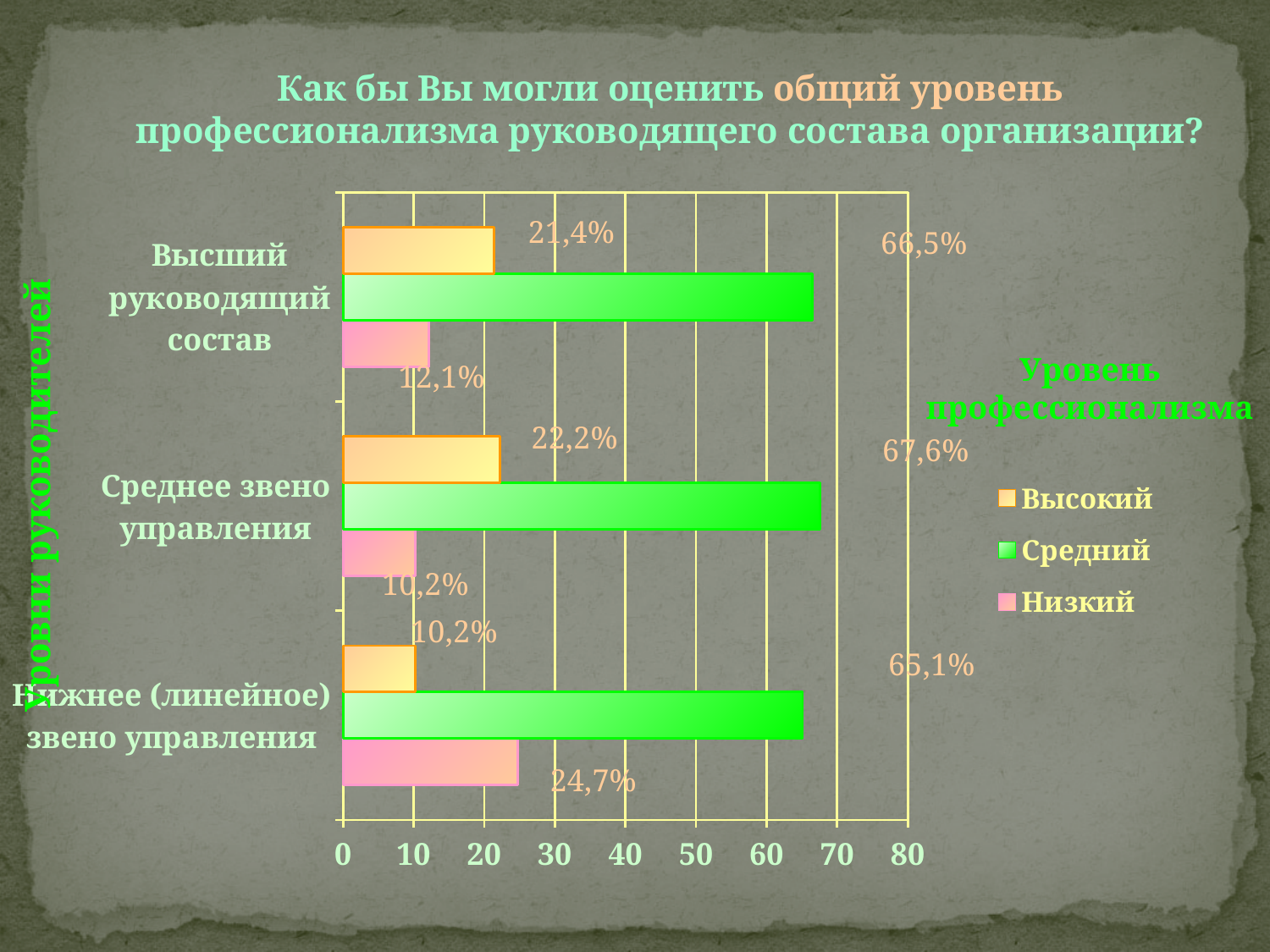
Which category has the lowest value for Высокий? Нижнее (линейное) звено управления What is the value of Низкий for Нижнее (линейное) звено управления? 24,7% What is the value of Низкий for Высший руководящий состав? 12,1% How many series does the legend list? 3 What is the value of Высокий for Среднее звено управления? 22,2% Which is larger for Высший руководящий состав: the Высокий value or the Низкий value? Высокий What type of chart is shown on the slide? bar chart What is the value of Средний for Высший руководящий состав? 66,5% How many categories are shown on the vertical axis? 3 What is the difference between the Низкий values for Нижнее (линейное) звено управления and Среднее звено управления? 14,5% Which category has the highest value for Средний? Среднее звено управления What is the title of the legend? Уровень профессионализма